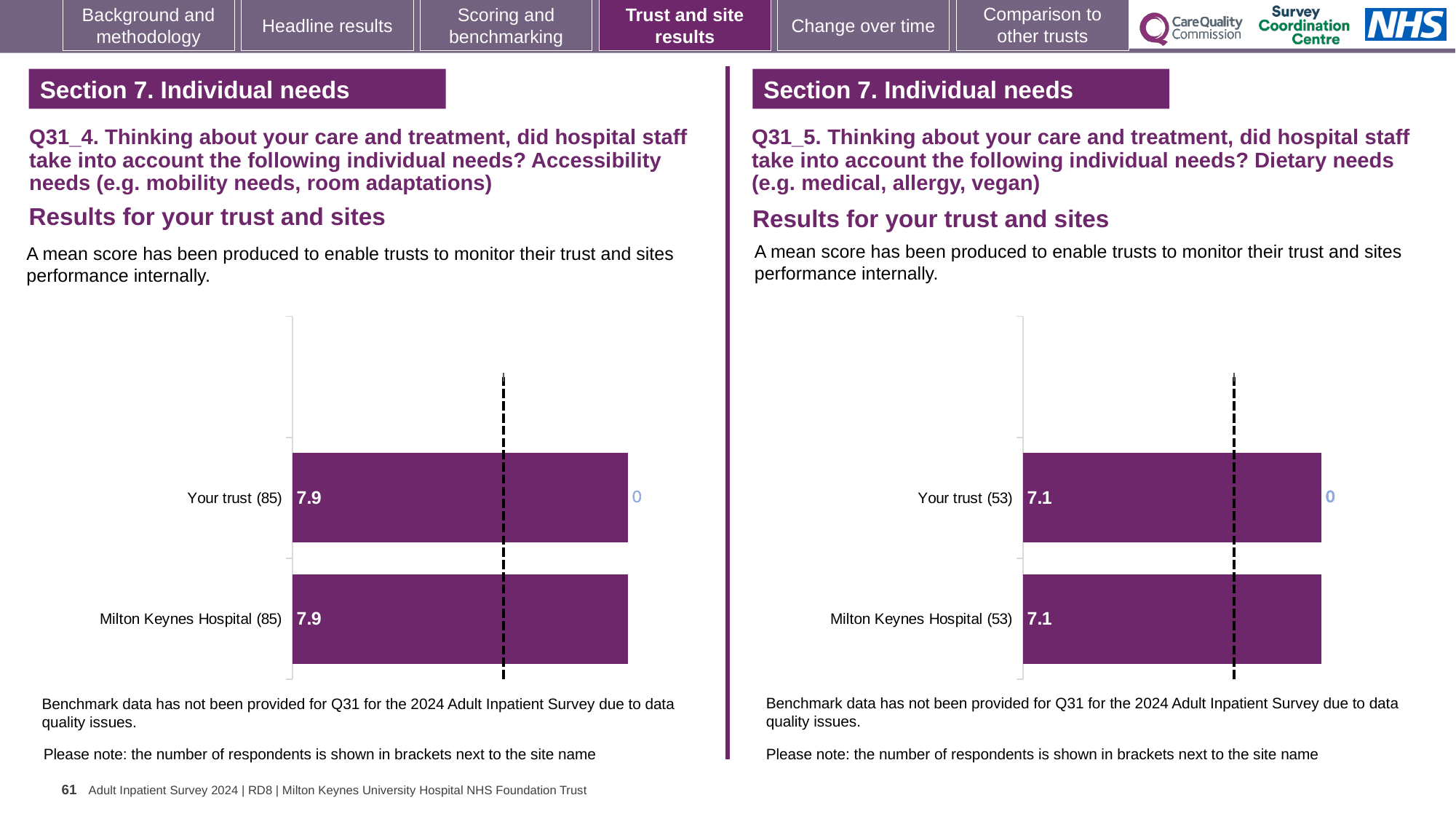
On the right chart (Q31_5), how many respondents are shown in brackets for Milton Keynes Hospital? 53 What type of chart is used on the left (Q31_4)? Bar chart How many bars are plotted on the left chart (Q31_4)? 2 How many bars are plotted on the right chart (Q31_5)? 2 On the left chart (Q31_4, accessibility needs), what is the mean score for Your trust? 7.9 On the left chart (Q31_4), how many respondents are shown in brackets for Your trust? 85 On the right chart (Q31_5, dietary needs), what is the mean score for Your trust? 7.1 Is the Your trust score on the left chart (Q31_4) larger or smaller than the Your trust score on the right chart (Q31_5)? Larger On the left chart (Q31_4), what is the difference between the scores for Your trust and Milton Keynes Hospital? 0 On the right chart (Q31_5), what is the difference between the scores for Your trust and Milton Keynes Hospital? 0 On the right chart (Q31_5, dietary needs), what is the mean score for Milton Keynes Hospital? 7.1 On the left chart (Q31_4, accessibility needs), what is the mean score for Milton Keynes Hospital? 7.9